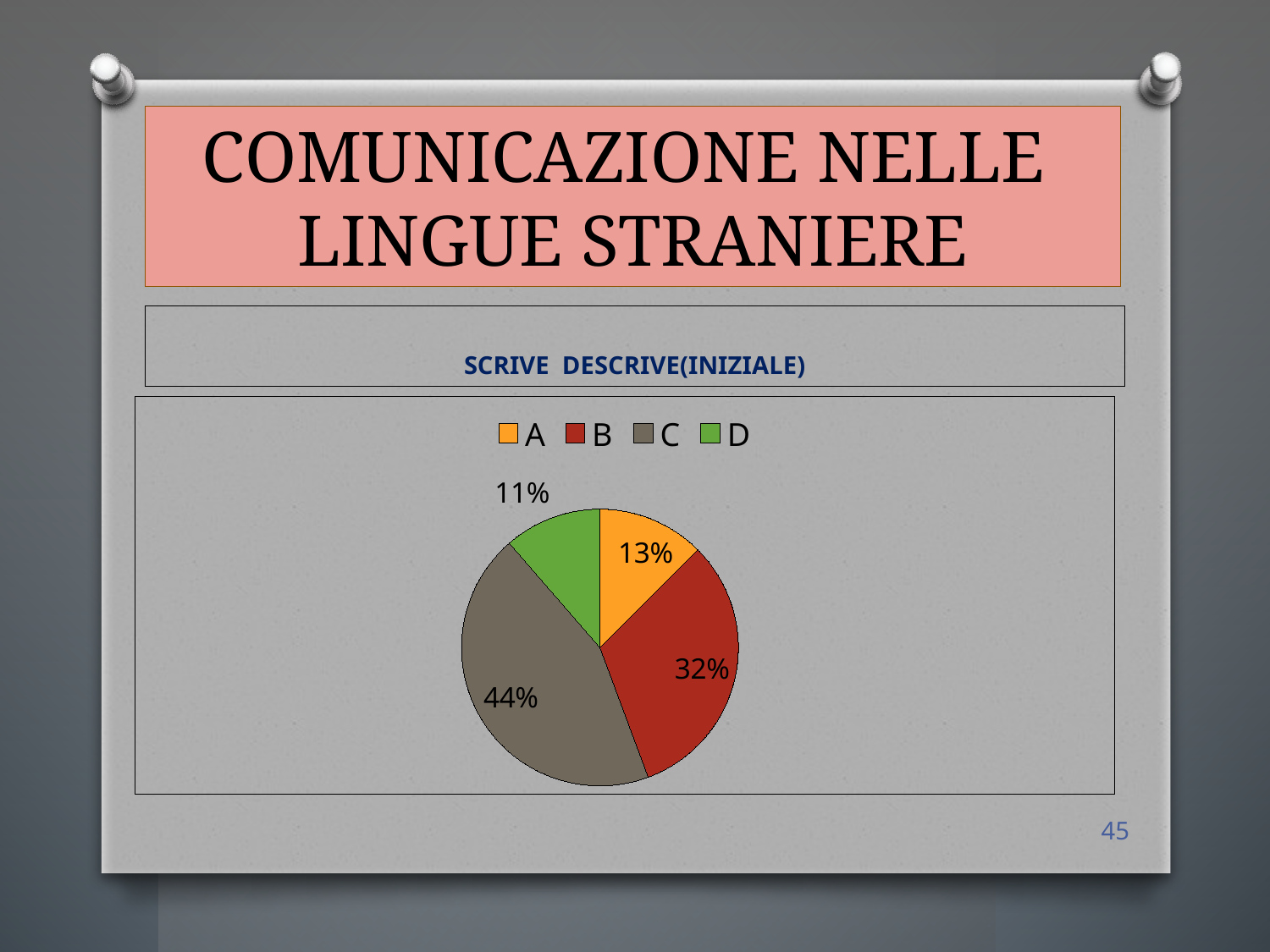
What share of the pie does slice B have? 32% What kind of chart is shown on the slide? pie chart How many slices does the pie chart have? 4 What is the difference in percentage points between slice C and slice B? 12 What share of the pie does slice D have? 11% What share of the pie does slice C have? 44% How many categories does the legend list? 4 What is the title shown above the pie chart? SCRIVE DESCRIVE(INIZIALE) Which category has the smallest slice of the pie? D Which is larger, slice A or slice D? A Which category has the largest slice of the pie? C